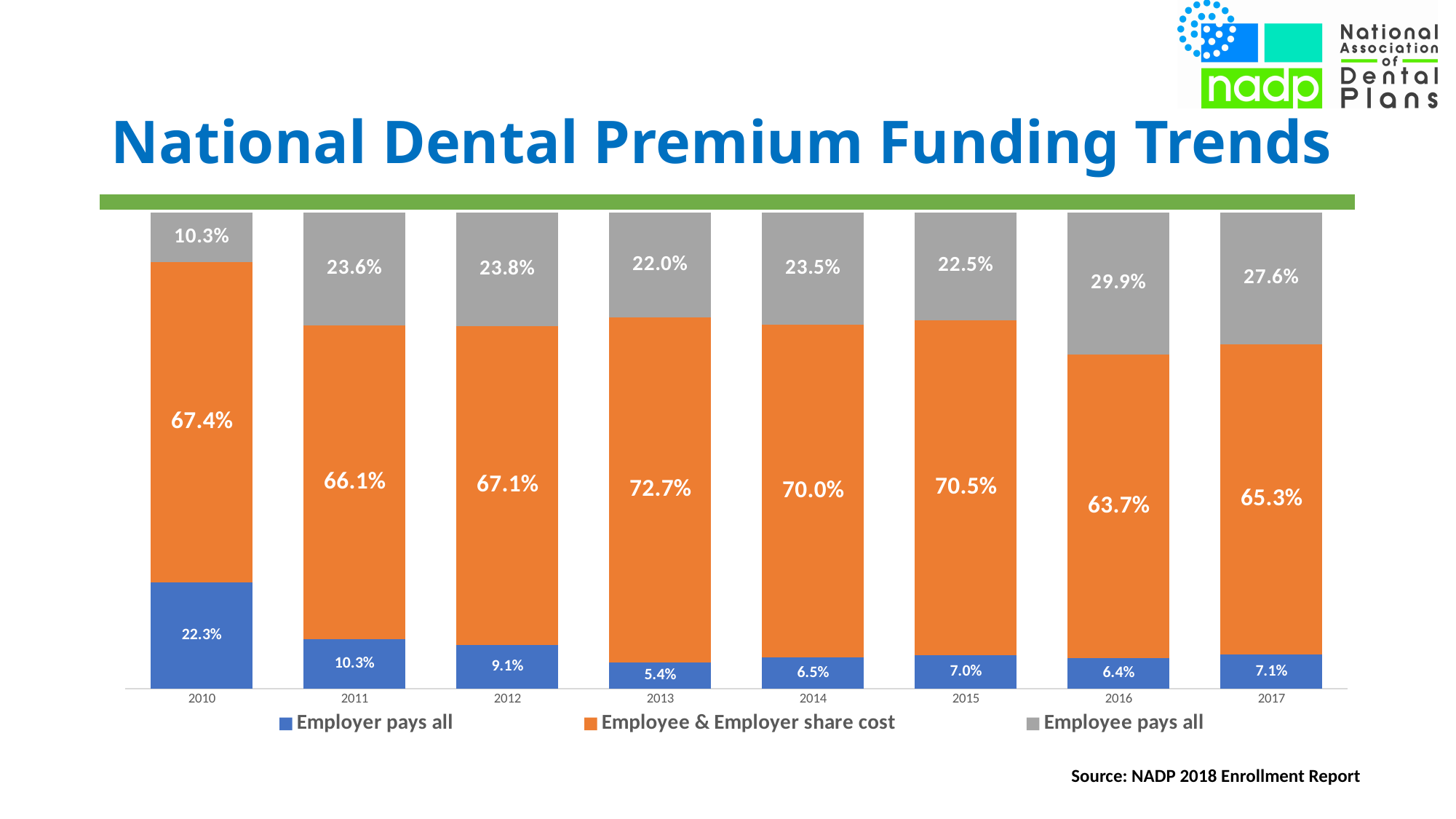
How many series does the legend list? 3 In which year is the 'Employee pays all' segment the highest? 2016 By how many percentage points did 'Employee pays all' increase from 2010 to 2017? 17.3 percentage points In which year is the 'Employer pays all' segment the lowest? 2013 What is the 'Employee pays all' value for 2016? 29.9% Which year has the larger 'Employer pays all' value, 2011 or 2012? 2011 What kind of chart is shown on the slide? Stacked bar chart In which year is the 'Employee & Employer share cost' segment the highest? 2013 Does the 'Employer pays all' value rise or fall from 2010 to 2013? Fall What percentage of dental premiums were funded under 'Employer pays all' in 2010? 22.3% What is the 'Employee & Employer share cost' value for 2013? 72.7% How many years are shown on the x axis of the chart? 8